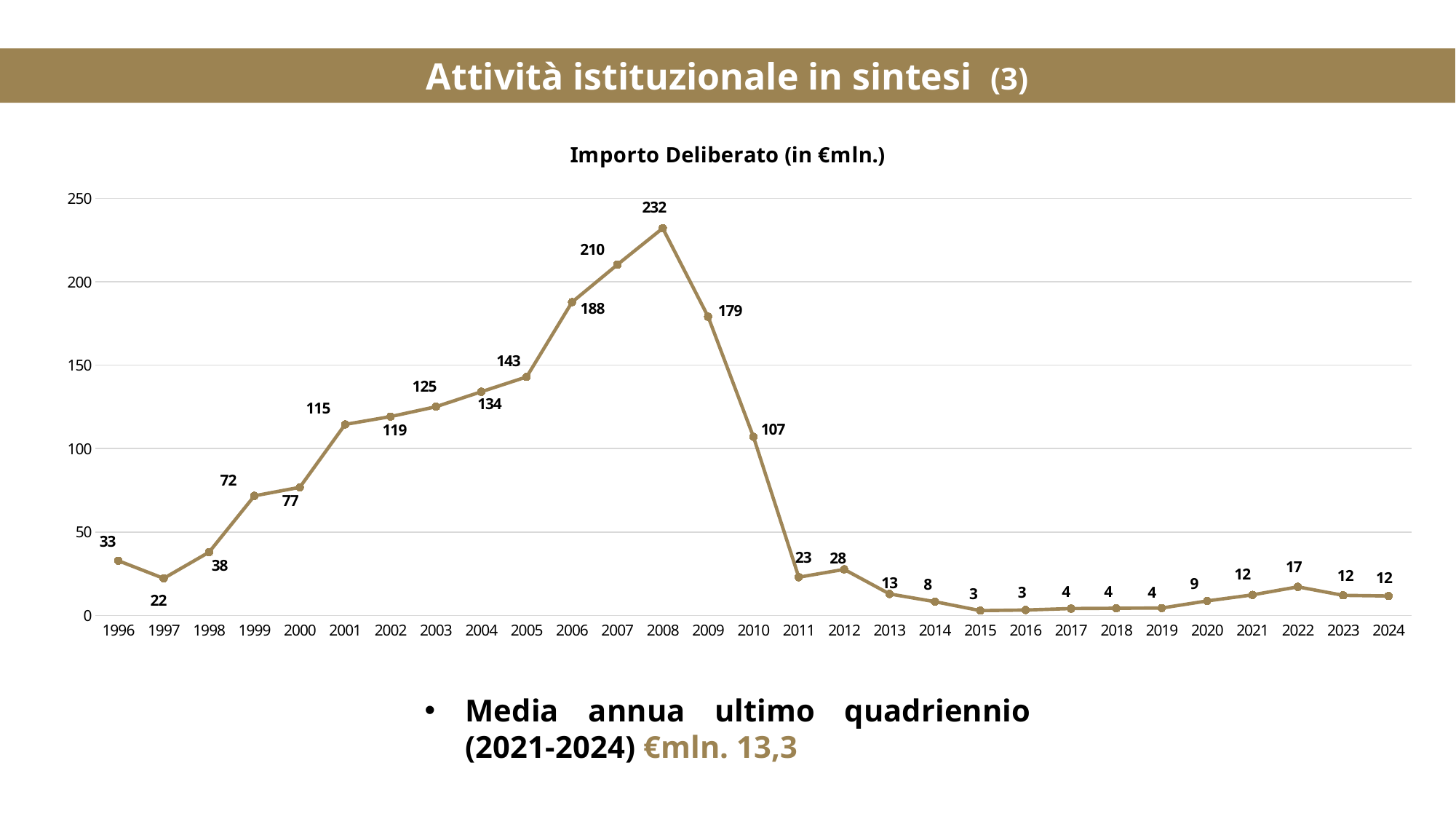
Which years have the lowest value? 2015 and 2016 What is the value for 2010? 107 Is the value for 2007 greater or less than 200? greater Which is larger, the value for 2001 or the value for 2002? 2002 What is the title of the chart? Importo Deliberato (in €mln.) Which year has the highest value? 2008 How many years are plotted on the x axis? 29 What is the difference between the values for 2008 and 2009? 53 Do the values rise or fall from 2008 to 2015? fall What is the value for 2022? 17 What kind of chart is shown? line chart What is the value for 2008? 232